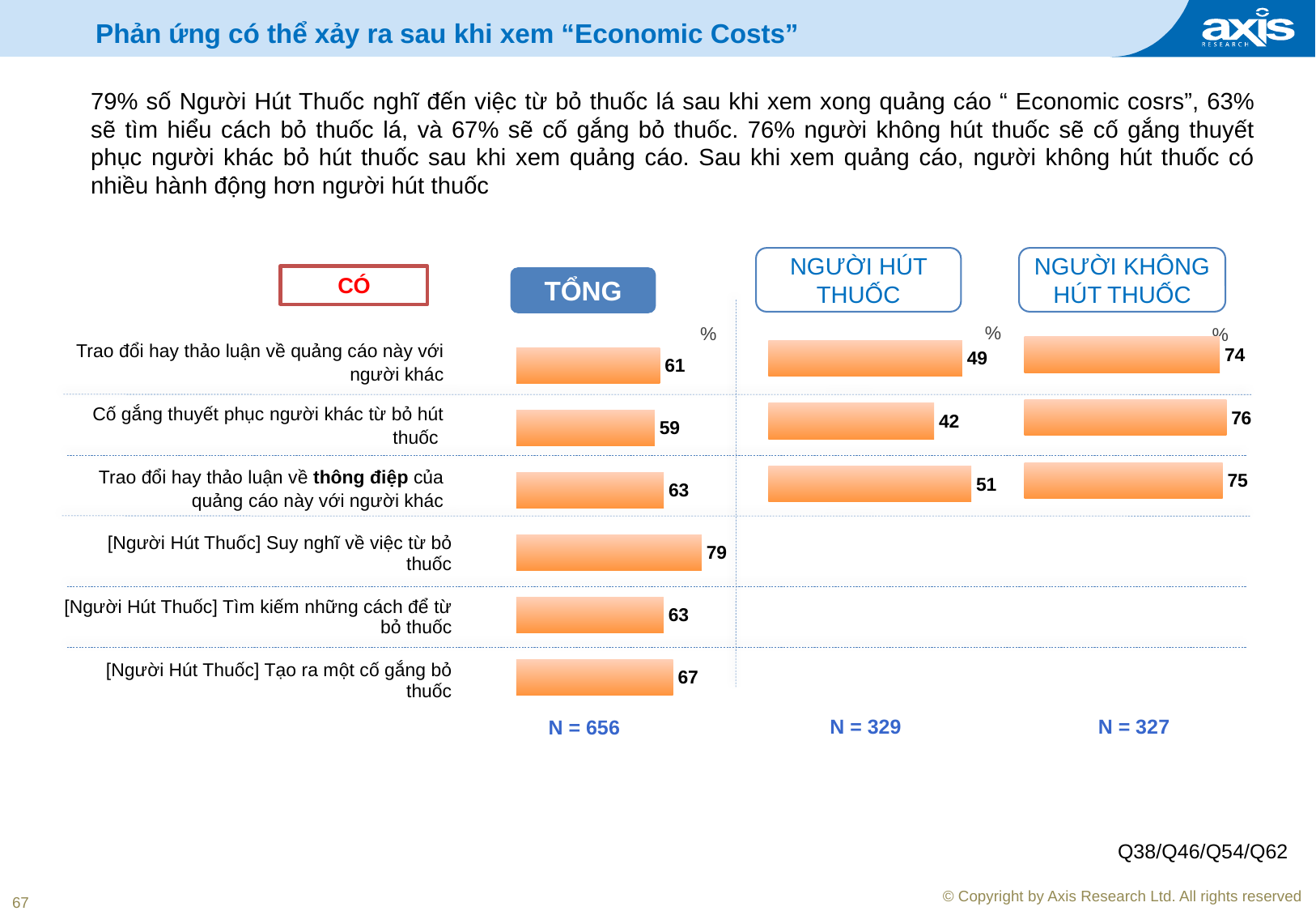
What type of chart is the TỔNG chart? Bar chart In the NGƯỜI HÚT THUỐC chart, what is the value for "Cố gắng thuyết phục người khác từ bỏ hút thuốc"? 42 In the NGƯỜI KHÔNG HÚT THUỐC chart, what is the value for "Trao đổi hay thảo luận về quảng cáo này với người khác"? 74 In the NGƯỜI HÚT THUỐC chart, which category has the lowest value? Cố gắng thuyết phục người khác từ bỏ hút thuốc How many categories are shown in the TỔNG chart? 6 What is the difference between the NGƯỜI KHÔNG HÚT THUỐC value and the NGƯỜI HÚT THUỐC value for "Cố gắng thuyết phục người khác từ bỏ hút thuốc"? 34 In the TỔNG chart, which category has the lowest value? Cố gắng thuyết phục người khác từ bỏ hút thuốc In the TỔNG chart, what is the value for "[Người Hút Thuốc] Suy nghĩ về việc từ bỏ thuốc"? 79 In the TỔNG chart, which category has the highest value? [Người Hút Thuốc] Suy nghĩ về việc từ bỏ thuốc For "Trao đổi hay thảo luận về thông điệp của quảng cáo này với người khác", which is larger: the NGƯỜI HÚT THUỐC value or the NGƯỜI KHÔNG HÚT THUỐC value? NGƯỜI KHÔNG HÚT THUỐC How many categories are shown in the NGƯỜI HÚT THUỐC chart? 3 What is the sample size (N) shown under the NGƯỜI KHÔNG HÚT THUỐC chart? N = 327